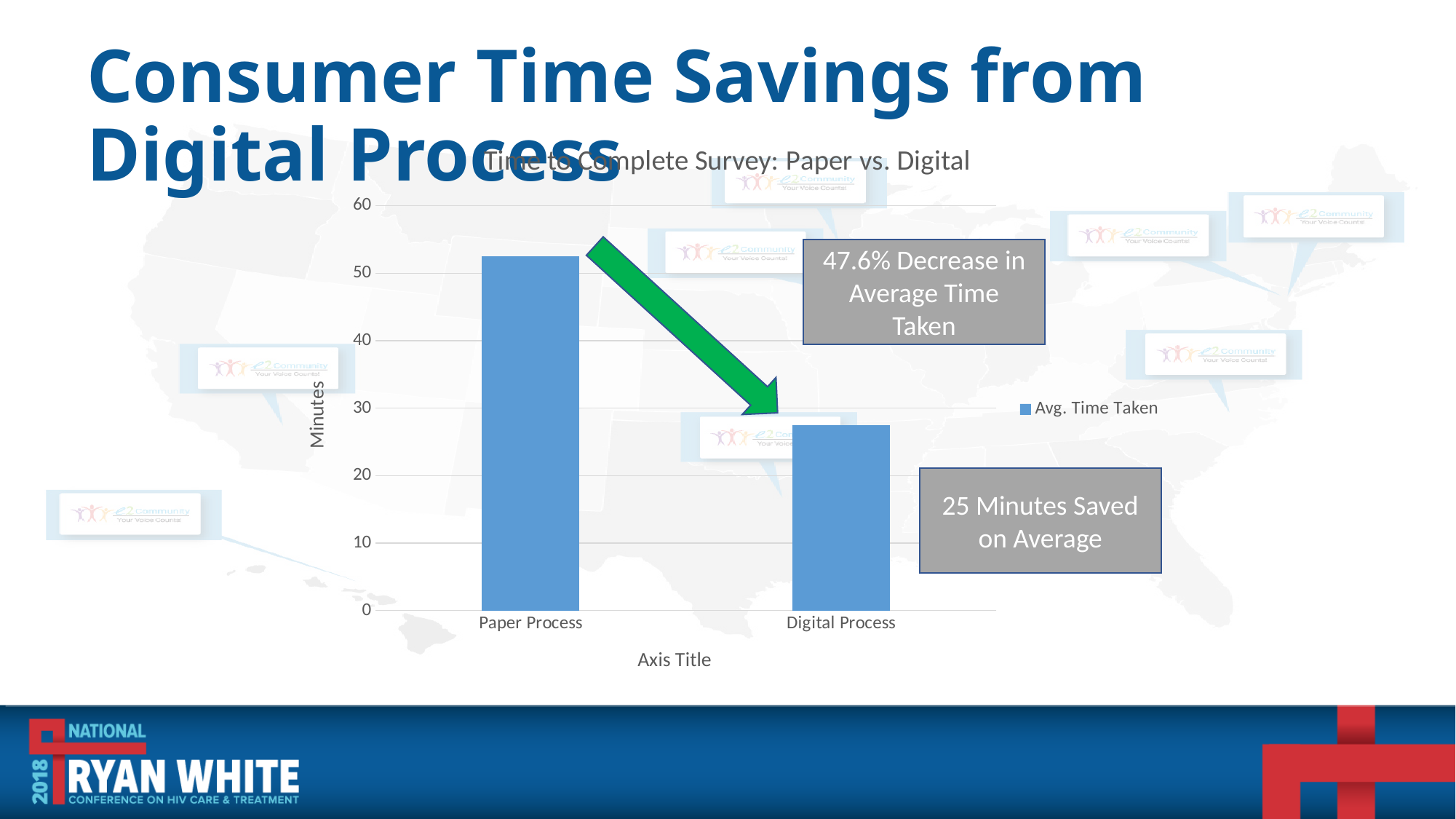
How many series does the chart's legend list? 1 Is the value for Digital Process greater or less than 20? greater Which category has the highest average time taken? Paper Process Is the value for Digital Process greater or less than 30? less What is the title of the chart? Time to Complete Survey: Paper vs. Digital What kind of chart is shown on the slide? bar chart What series name is shown in the chart's legend? Avg. Time Taken How many categories are plotted on the x axis of the chart? 2 Which category has the lowest average time taken? Digital Process Which is larger, the average time taken for Paper Process or for Digital Process? Paper Process Is the value for Paper Process greater or less than 50? greater